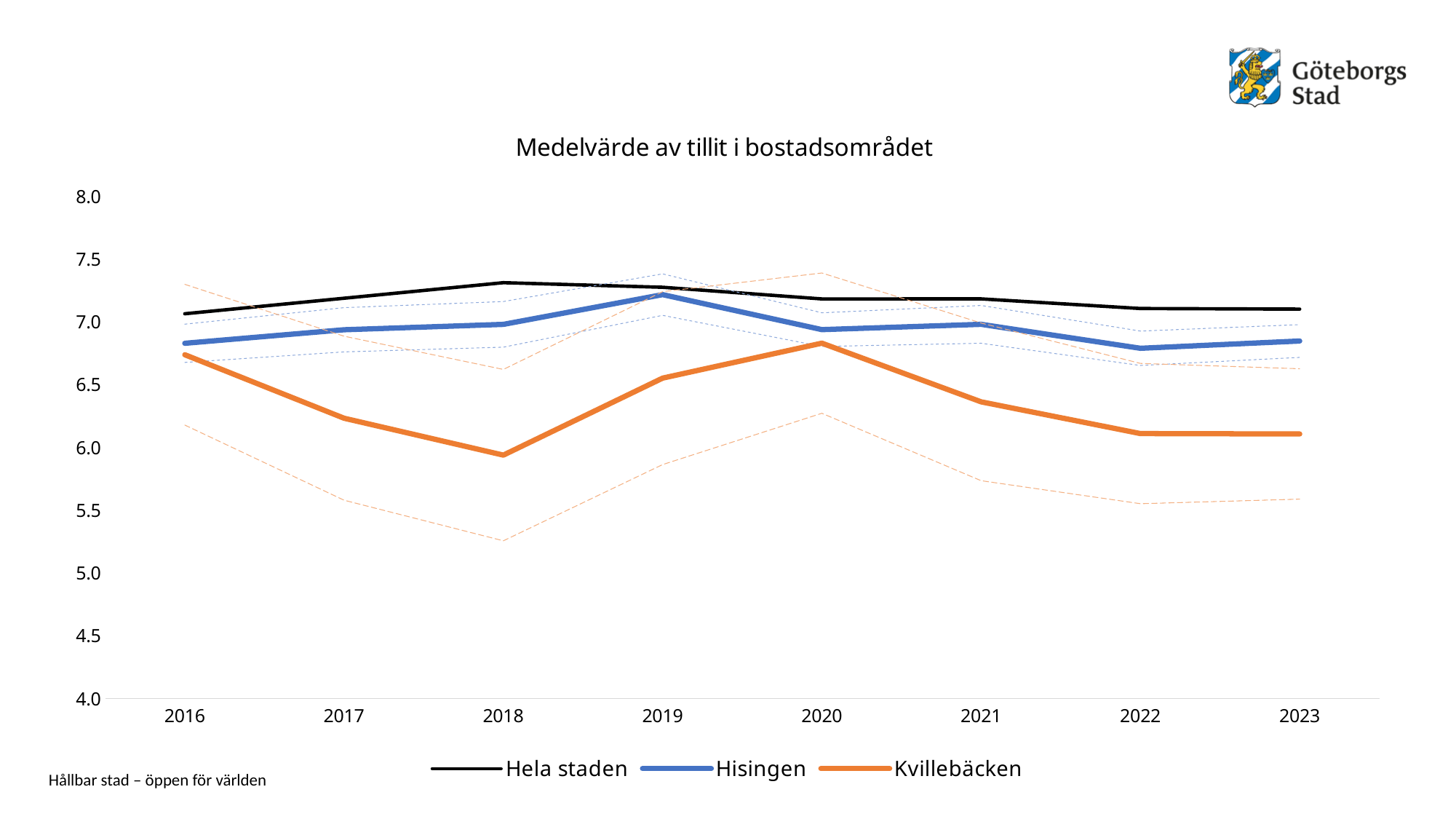
How many years are shown on the x axis? 8 What kind of chart is shown on the slide? Line chart Is the value for Hisingen in 2019 greater or less than 7.0? greater Is the value for Kvillebäcken in 2023 greater or less than 6.5? less In which year is the value for Hisingen highest? 2019 In 2018, which is larger: the value for Hisingen or the value for Kvillebäcken? Hisingen Does the value for Kvillebäcken rise or fall from 2016 to 2018? Fall How many series does the legend list? 3 In which year is the value for Kvillebäcken lowest? 2018 What is the title of the chart? Medelvärde av tillit i bostadsområdet Is the value for Hela staden in 2018 greater or less than 7.0? greater